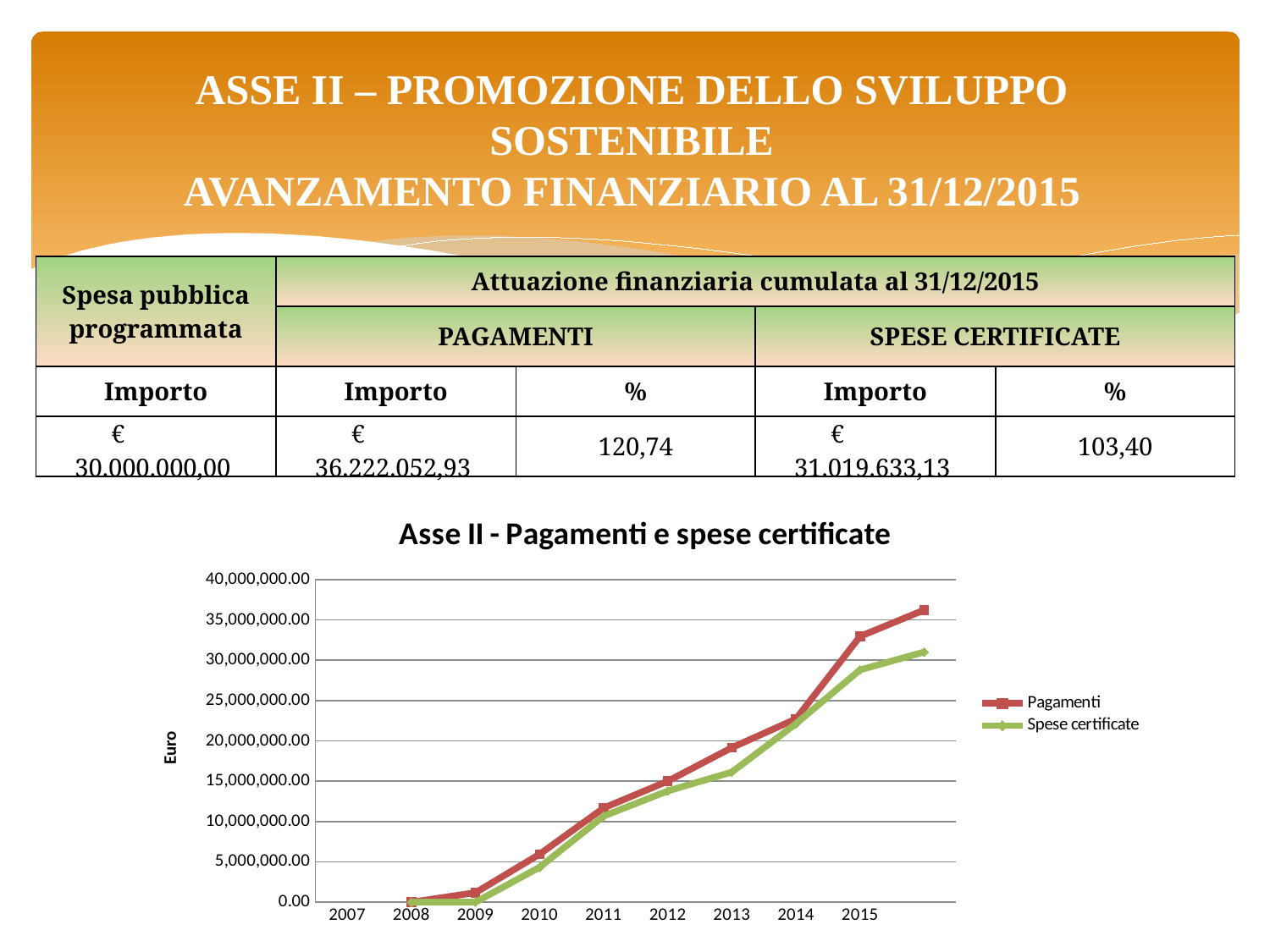
At 2015, which series has the higher value, Pagamenti or Spese certificate? Pagamenti What is the label on the vertical axis of the chart? Euro How many year labels are shown on the x axis of the chart? 9 What is the title of the chart? Asse II - Pagamenti e spese certificate How many series does the chart legend list? 2 What type of chart is shown on the slide? line chart Is the value for Pagamenti at 2015 greater or less than 30,000,000.00? greater Do the values of the Pagamenti series rise or fall from 2008 to 2015? rise Is the value for Spese certificate at 2009 greater or less than 5,000,000.00? less Is the value for Spese certificate at 2015 greater or less than 25,000,000.00? greater At 2011, which series has the higher value, Pagamenti or Spese certificate? Pagamenti